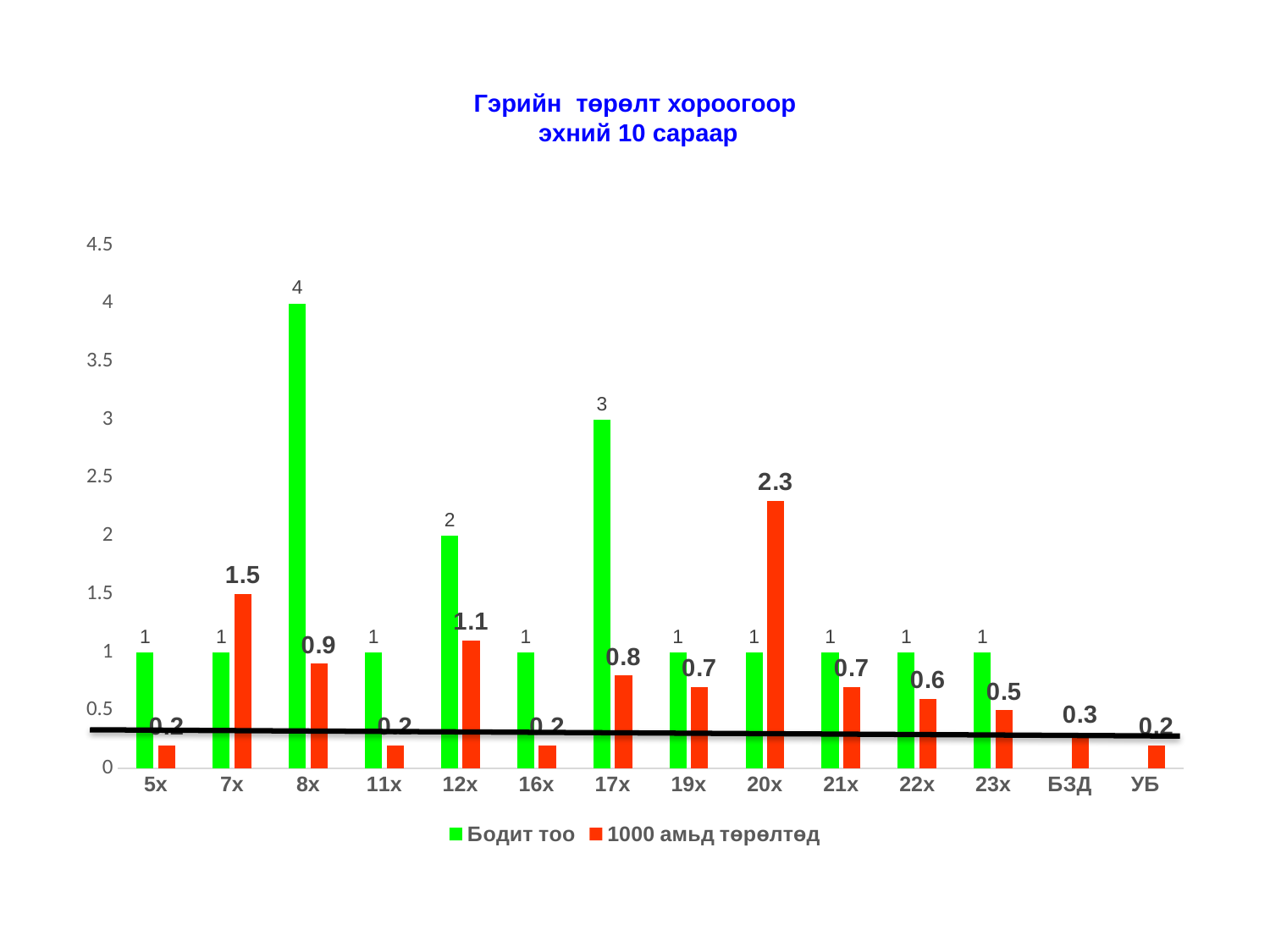
How many categories are shown on the x axis? 14 What colour are the bars for the series Бодит тоо? green What is the value of 1000 амьд төрөлтөд for 20х? 2.3 What kind of chart is shown on the slide? bar chart Which category has the highest value for 1000 амьд төрөлтөд? 20х What is the value of 1000 амьд төрөлтөд for 7х? 1.5 What is the value of 1000 амьд төрөлтөд for БЗД? 0.3 Which is larger: the 1000 амьд төрөлтөд value for 12х or for 17х? 12х What is the difference between the Бодит тоо values for 8х and 17х? 1 What is the value of Бодит тоо for 8х? 4 How many series does the legend list? 2 Which category has the highest value for Бодит тоо? 8х